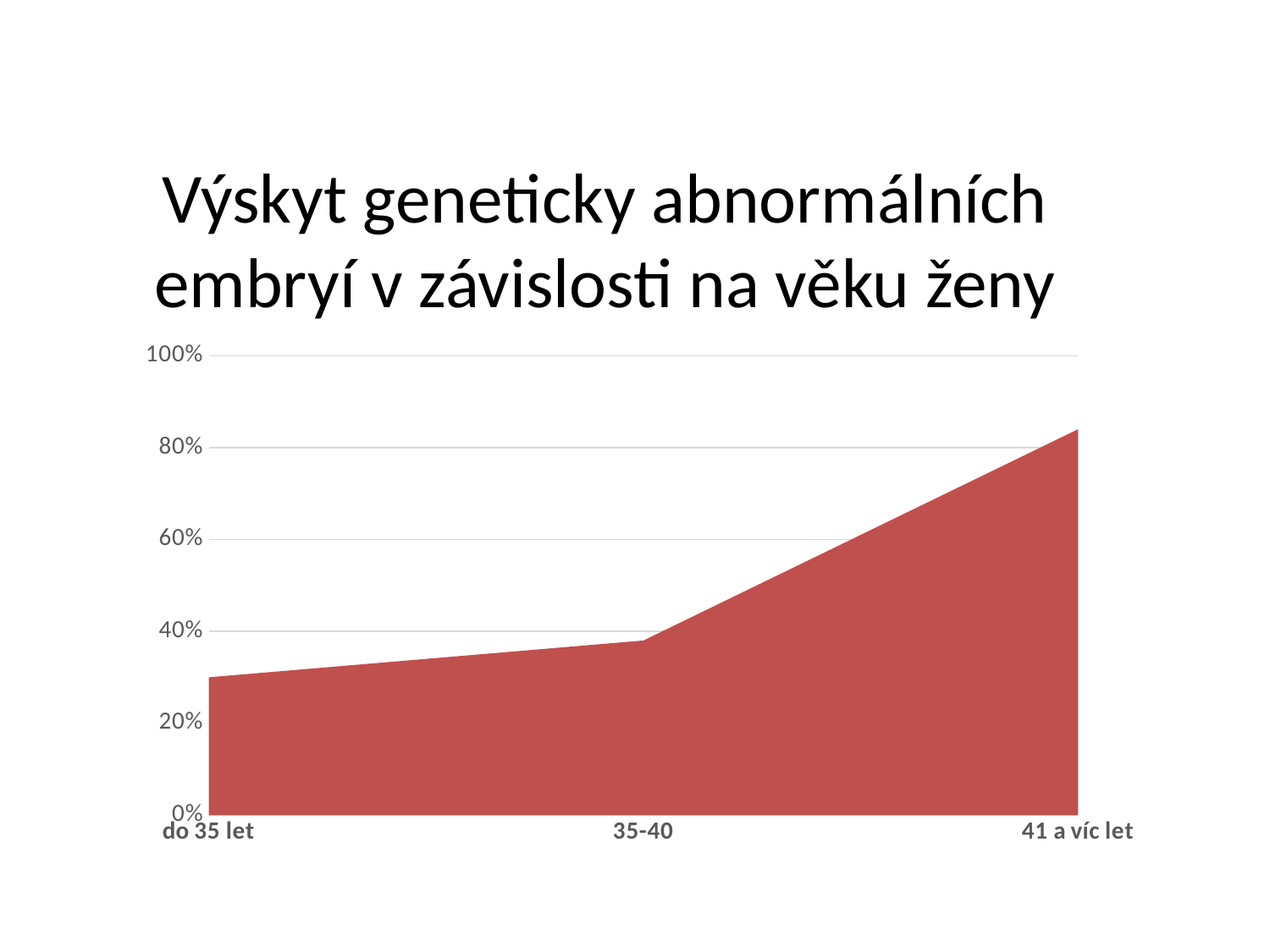
Is the value for '35-40' greater or less than 20%? greater What is the title of the slide? Výskyt geneticky abnormálních embryí v závislosti na věku ženy Which age category has the highest value? 41 a víc let Which is larger, the value for 'do 35 let' or the value for '35-40'? 35-40 What kind of chart is shown on the slide? area chart Which is larger, the value for '35-40' or the value for '41 a víc let'? 41 a víc let Do the values rise or fall from 'do 35 let' to '41 a víc let'? rise Is the value for '41 a víc let' greater or less than 80%? greater How many age categories are shown on the x axis? 3 Which age category has the lowest value? do 35 let Is the value for 'do 35 let' greater or less than 40%? less